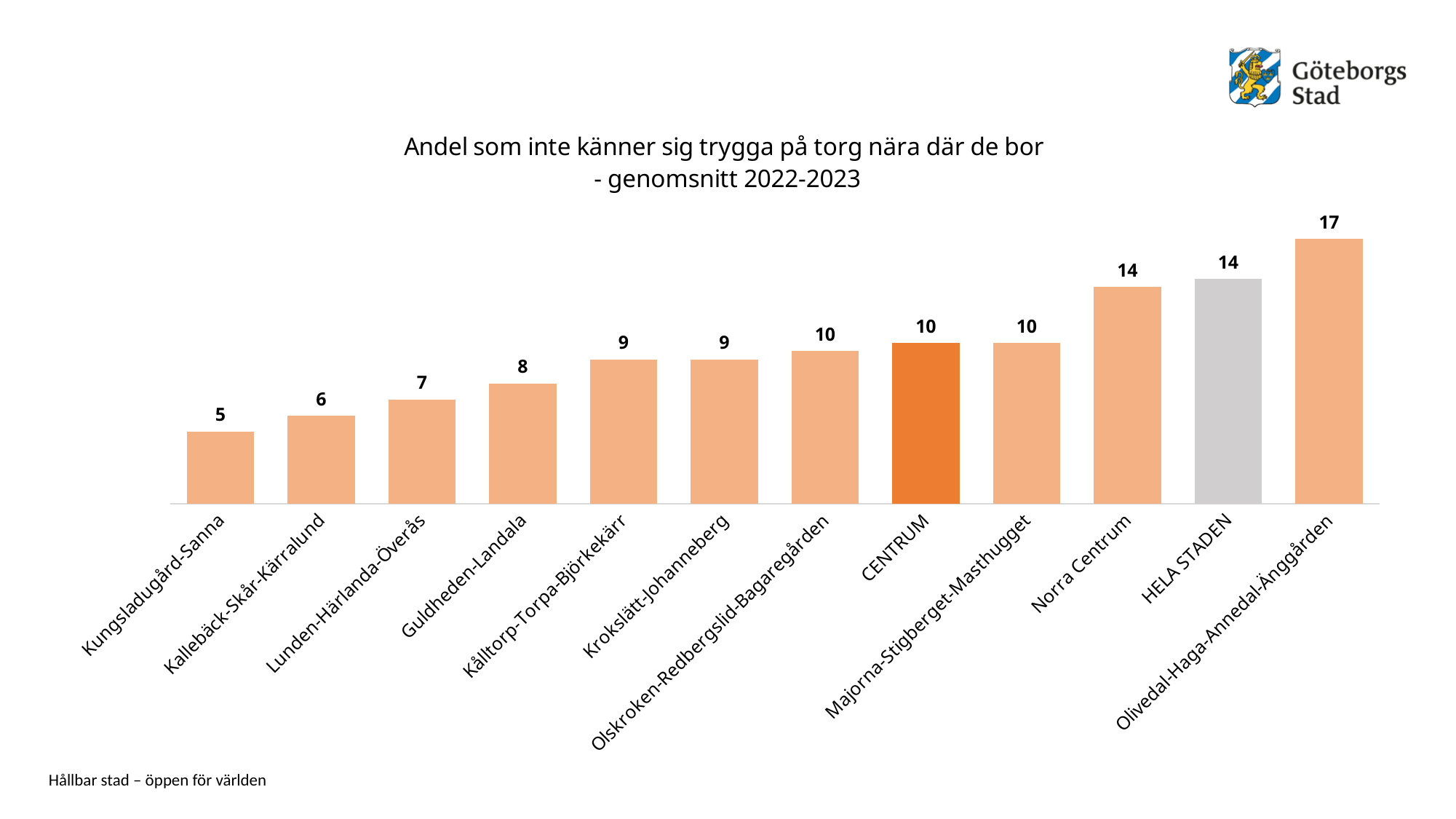
How many categories are shown on the x axis? 12 Do the values rise or fall from left to right along the x axis? Rise What is the value for Olivedal-Haga-Annedal-Änggården? 17 What is the difference between the values for HELA STADEN and CENTRUM? 4 Which category has the highest value? Olivedal-Haga-Annedal-Änggården What is the value for Guldheden-Landala? 8 What is the value for HELA STADEN? 14 What is the difference between the values for Olivedal-Haga-Annedal-Änggården and Kungsladugård-Sanna? 12 Which category has the lowest value? Kungsladugård-Sanna What is the value for CENTRUM? 10 Which is larger, the value for Norra Centrum or the value for Kallebäck-Skår-Kärralund? Norra Centrum What kind of chart is shown on the slide? Bar chart